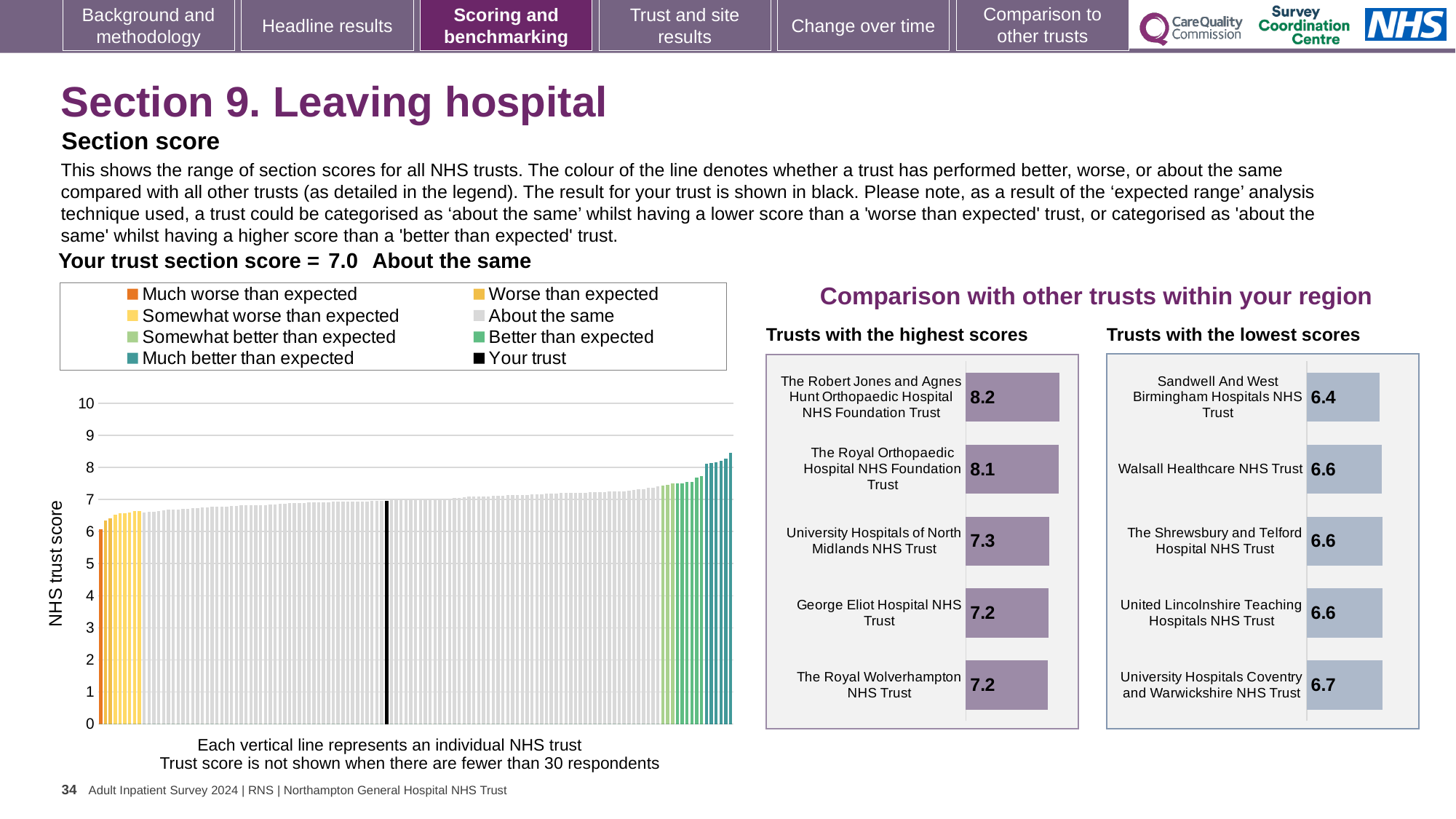
In the 'Trusts with the highest scores' chart, which trust has the highest score? The Robert Jones and Agnes Hunt Orthopaedic Hospital NHS Foundation Trust In the 'Trusts with the lowest scores' chart, what is the difference between the scores of University Hospitals Coventry and Warwickshire NHS Trust and Sandwell And West Birmingham Hospitals NHS Trust? 0.3 In the 'Trusts with the highest scores' chart, what is the score for The Robert Jones and Agnes Hunt Orthopaedic Hospital NHS Foundation Trust? 8.2 In the 'Trusts with the lowest scores' chart, which trust has the lowest score? Sandwell And West Birmingham Hospitals NHS Trust In the 'Trusts with the lowest scores' chart, what is the score for University Hospitals Coventry and Warwickshire NHS Trust? 6.7 How many entries does the legend of the 'NHS trust score' chart list? 8 In the 'Trusts with the highest scores' chart, which has the higher score: The Royal Orthopaedic Hospital NHS Foundation Trust or University Hospitals of North Midlands NHS Trust? The Royal Orthopaedic Hospital NHS Foundation Trust In the 'Trusts with the lowest scores' chart, what is the score for Sandwell And West Birmingham Hospitals NHS Trust? 6.4 In the 'Trusts with the highest scores' chart, what is the difference between the scores of The Robert Jones and Agnes Hunt Orthopaedic Hospital NHS Foundation Trust and George Eliot Hospital NHS Trust? 1.0 What kind of chart is the large 'NHS trust score' chart on the left of the slide? Bar chart In the 'NHS trust score' chart, is the highest trust score greater or less than 8? greater How many trusts are listed in the 'Trusts with the highest scores' chart? 5